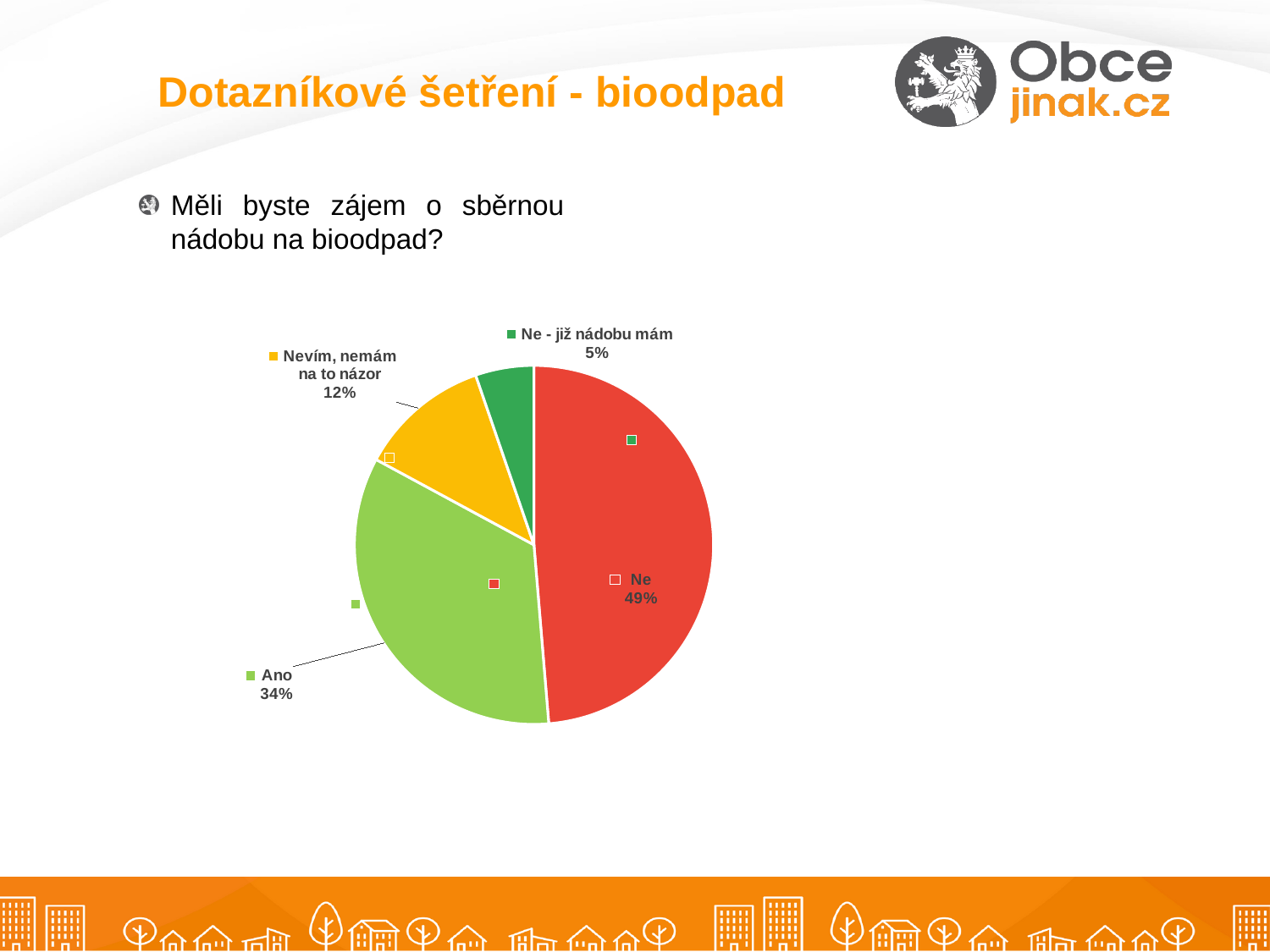
What share of the pie does "Nevím, nemám na to názor" have? 12% What share of the pie does "Ano" have? 34% What colour is the "Ano" slice of the pie? green Which slice of the pie is the largest? Ne What kind of chart is shown on the slide? pie chart Which slice of the pie is the smallest? Ne - již nádobu mám What is the difference in percentage points between "Nevím, nemám na to názor" and "Ne - již nádobu mám"? 7 How many slices does the pie chart have? 4 What share of the pie does "Ne" have? 49% Which is larger, the share for "Ano" or the share for "Nevím, nemám na to názor"? Ano What is the difference in percentage points between "Ne" and "Ano"? 15